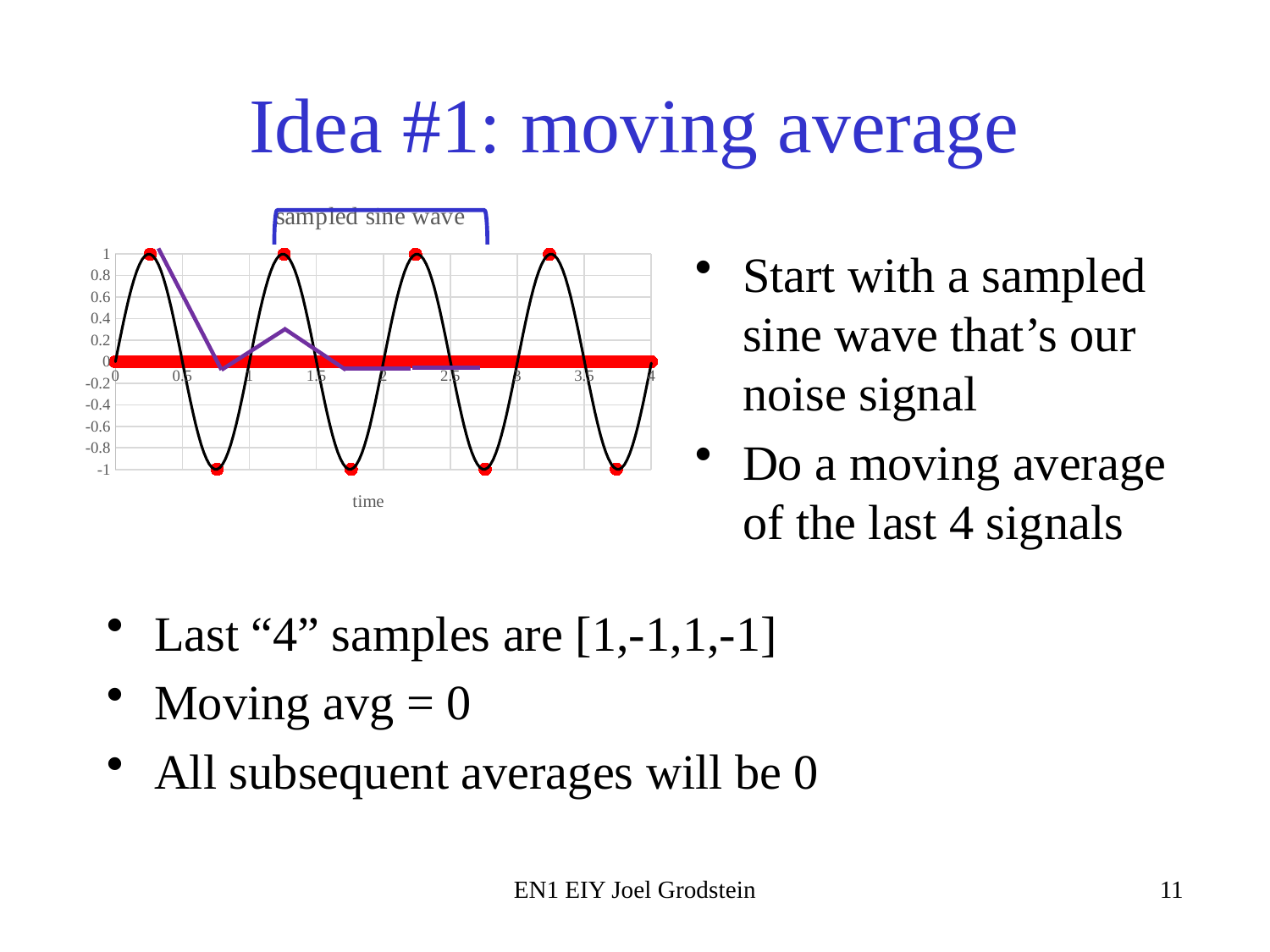
What is the label on the x axis of the chart? time How many red dots mark the troughs (value -1) of the sine wave? 4 How many red dots mark the peaks (value 1) of the sine wave? 4 Is the value of the sine wave at time 0.75 greater or less than 0? less Which is larger, the value of the sine wave at time 1.25 or at time 1.75? time 1.25 What is the highest value the sine wave reaches on the chart? 1 Is the value of the sine wave at time 0.25 greater or less than 0? greater What is the title of the chart? sampled sine wave What is the largest value shown on the x axis of the chart? 4 What kind of chart is shown on the slide? line chart What is the difference between the peak value and the trough value of the sine wave? 2 What is the lowest value the sine wave reaches on the chart? -1